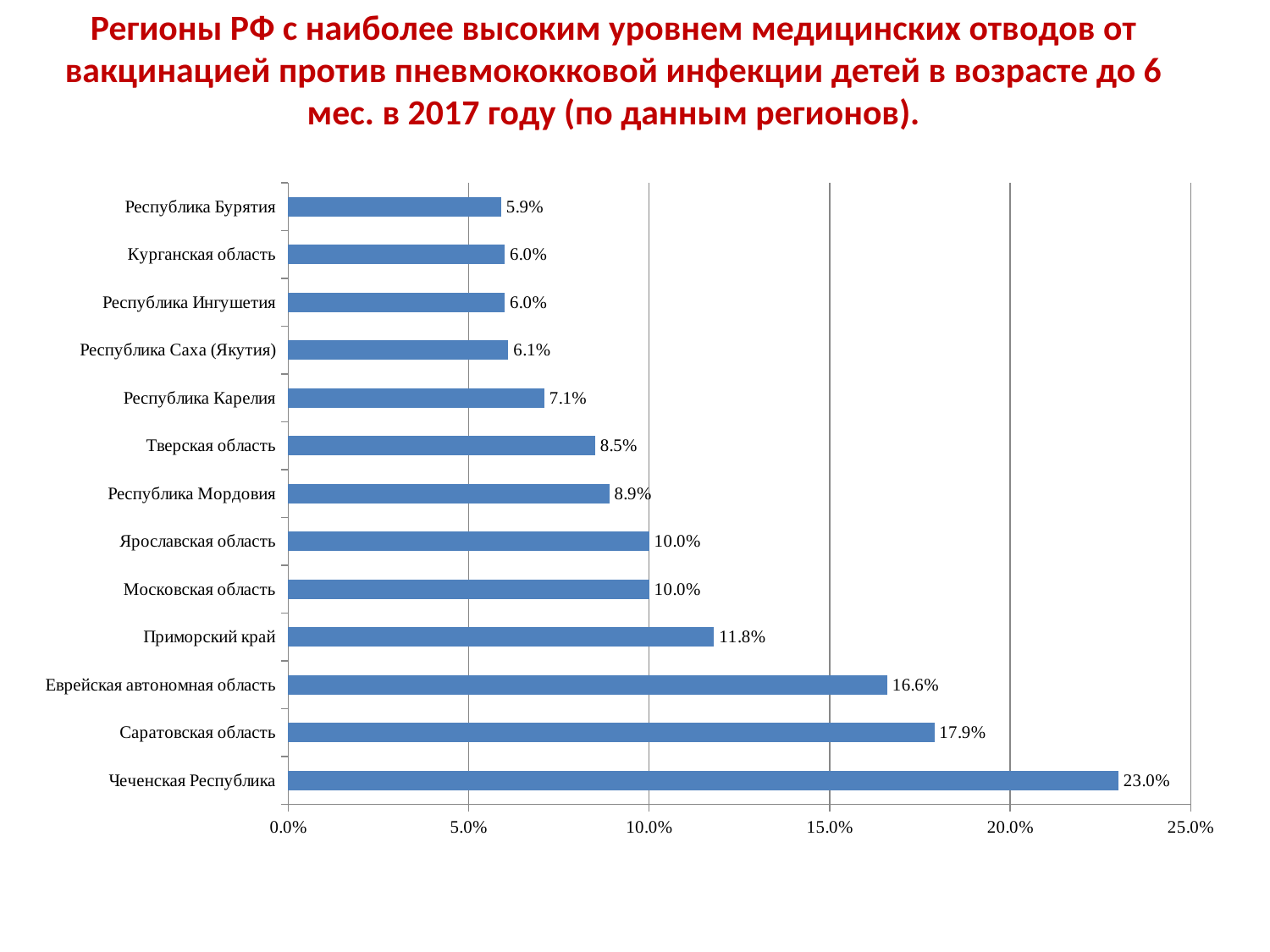
Which is larger, the value for Тверская область or the value for Республика Мордовия? Республика Мордовия Is the value for Еврейская автономная область greater or less than 15.0%? greater What is the value for Республика Карелия? 7.1% Which region has the lowest value? Республика Бурятия What is the difference between the values for Саратовская область and Приморский край? 6.1% What is the difference between the values for Чеченская Республика and Саратовская область? 5.1% How many regions are shown in the chart? 13 What kind of chart is shown on the slide? bar chart What is the value for Еврейская автономная область? 16.6% What is the value for Чеченская Республика? 23.0% Which region has the highest value? Чеченская Республика What is the maximum value shown on the horizontal axis? 25.0%